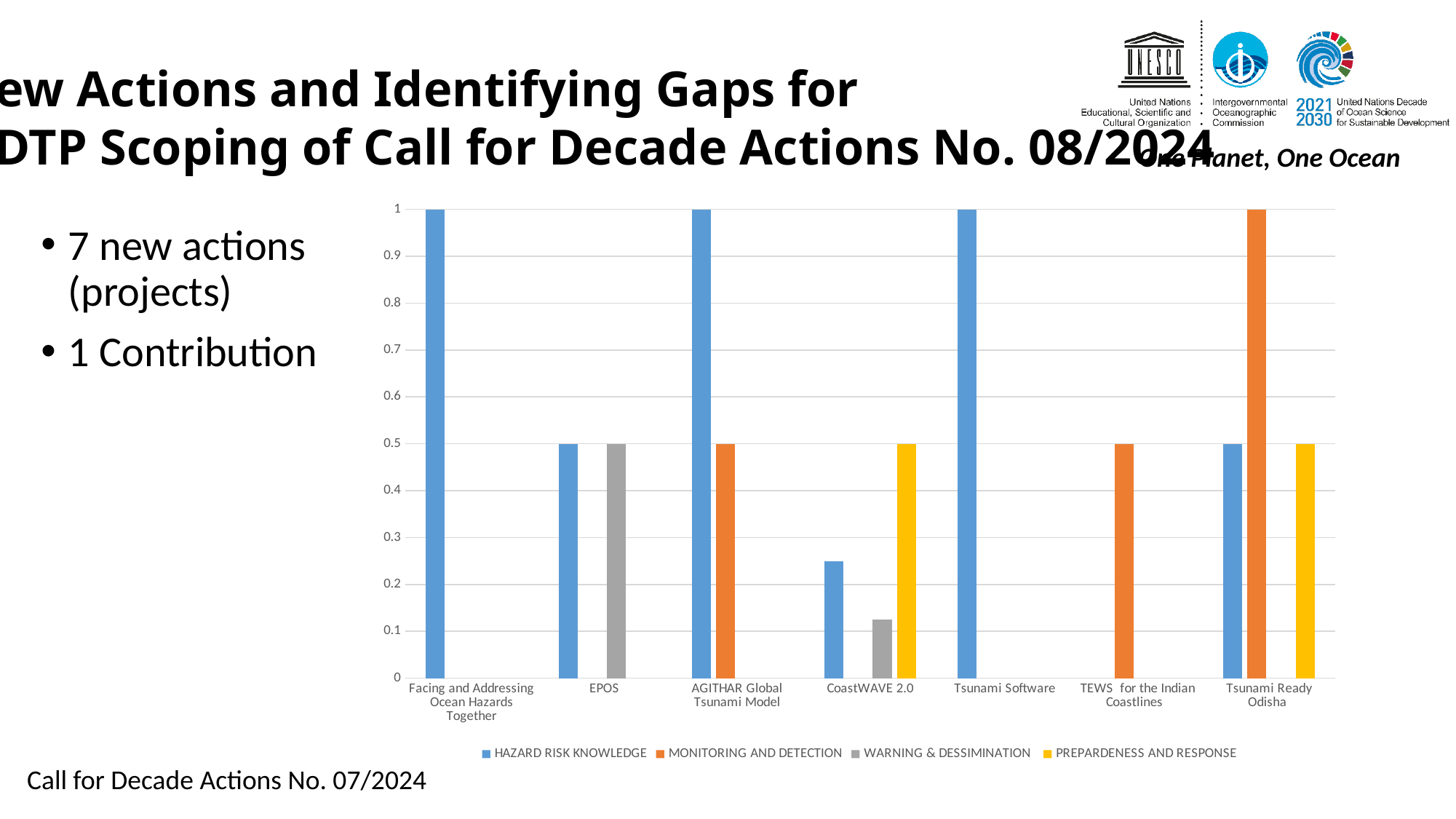
Is the HAZARD RISK KNOWLEDGE value for CoastWAVE 2.0 greater or less than 0.3? less What kind of chart is shown on the slide? bar chart What is the HAZARD RISK KNOWLEDGE value for Tsunami Software? 1 What is the MONITORING AND DETECTION value for TEWS for the Indian Coastlines? 0.5 What is the WARNING & DESSIMINATION value for EPOS? 0.5 How many categories (actions) are shown along the x axis of the chart? 7 What colour represents PREPARDENESS AND RESPONSE in the chart legend? yellow For AGITHAR Global Tsunami Model, which is larger: HAZARD RISK KNOWLEDGE or MONITORING AND DETECTION? HAZARD RISK KNOWLEDGE How many series does the chart legend list? 4 For Tsunami Ready Odisha, what is the difference between the MONITORING AND DETECTION value and the HAZARD RISK KNOWLEDGE value? 0.5 What is the MONITORING AND DETECTION value for Tsunami Ready Odisha? 1 Which category has the highest MONITORING AND DETECTION value? Tsunami Ready Odisha